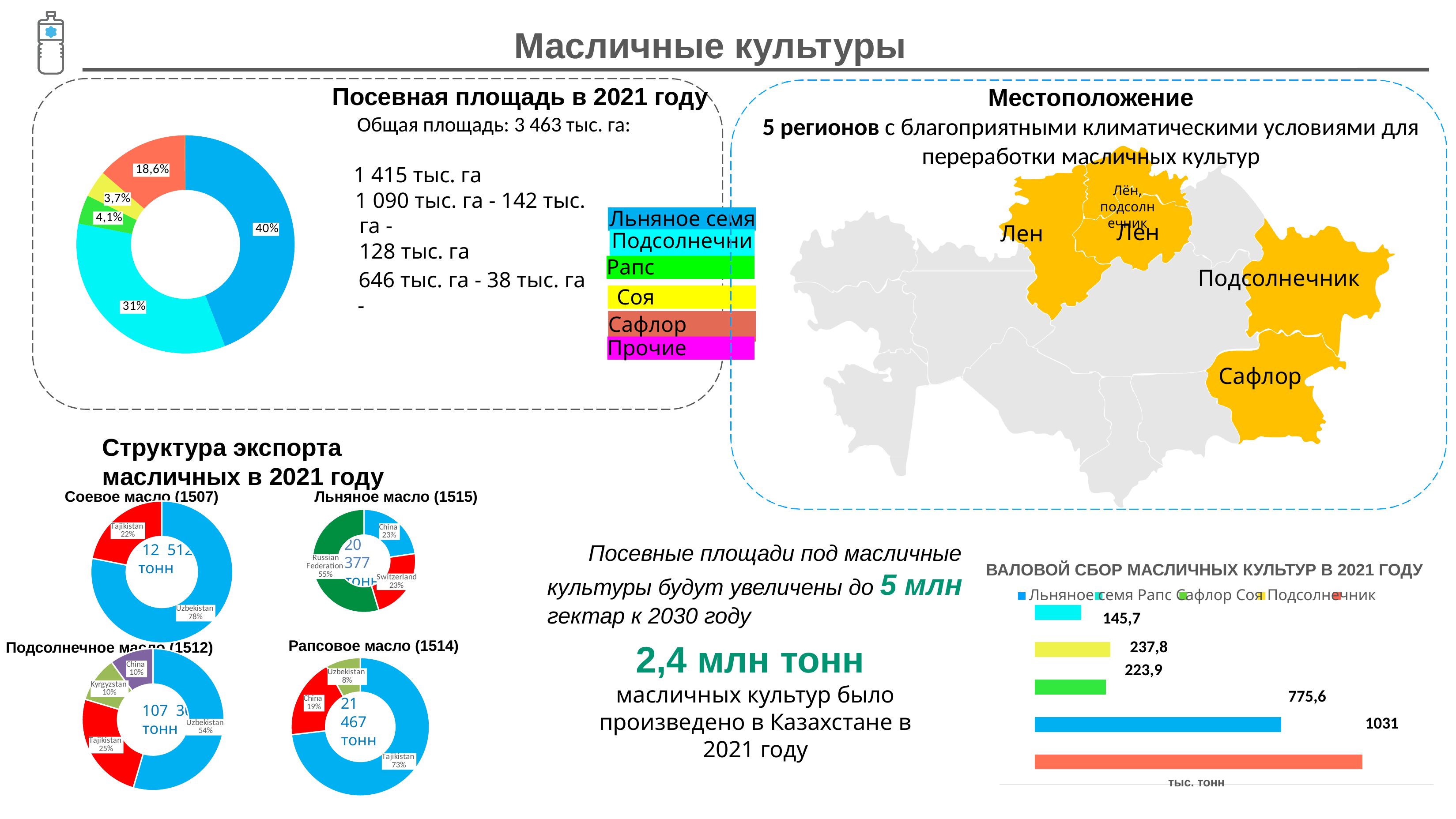
In the 'Посевная площадь в 2021 году' donut chart, which crop has the largest share? Льняное семя In the 'ВАЛОВОЙ СБОР МАСЛИЧНЫХ КУЛЬТУР В 2021 ГОДУ' bar chart, what is the largest value shown? 1031 What kind of chart is 'ВАЛОВОЙ СБОР МАСЛИЧНЫХ КУЛЬТУР В 2021 ГОДУ'? Bar chart In the 'Льняное масло (1515)' donut chart, which country has the largest share? Russian Federation In the 'Рапсовое масло (1514)' donut chart, what share does Tajikistan have? 73% What total volume in tonnes is shown in the centre of the 'Рапсовое масло (1514)' donut chart? 21 467 тонн In the 'Посевная площадь в 2021 году' donut chart, which slice is larger: Рапс or Соя? Рапс In the 'Посевная площадь в 2021 году' donut chart, what is the difference in percentage points between the Льняное семя and Подсолнечник slices? 9 How many entries does the legend of the 'Посевная площадь в 2021 году' donut chart list? 6 In the 'Соевое масло (1507)' donut chart, what share does Uzbekistan have? 78% In the 'Посевная площадь в 2021 году' donut chart, what share is shown for Льняное семя? 40% In the 'ВАЛОВОЙ СБОР МАСЛИЧНЫХ КУЛЬТУР В 2021 ГОДУ' bar chart, what is the smallest value shown? 145,7